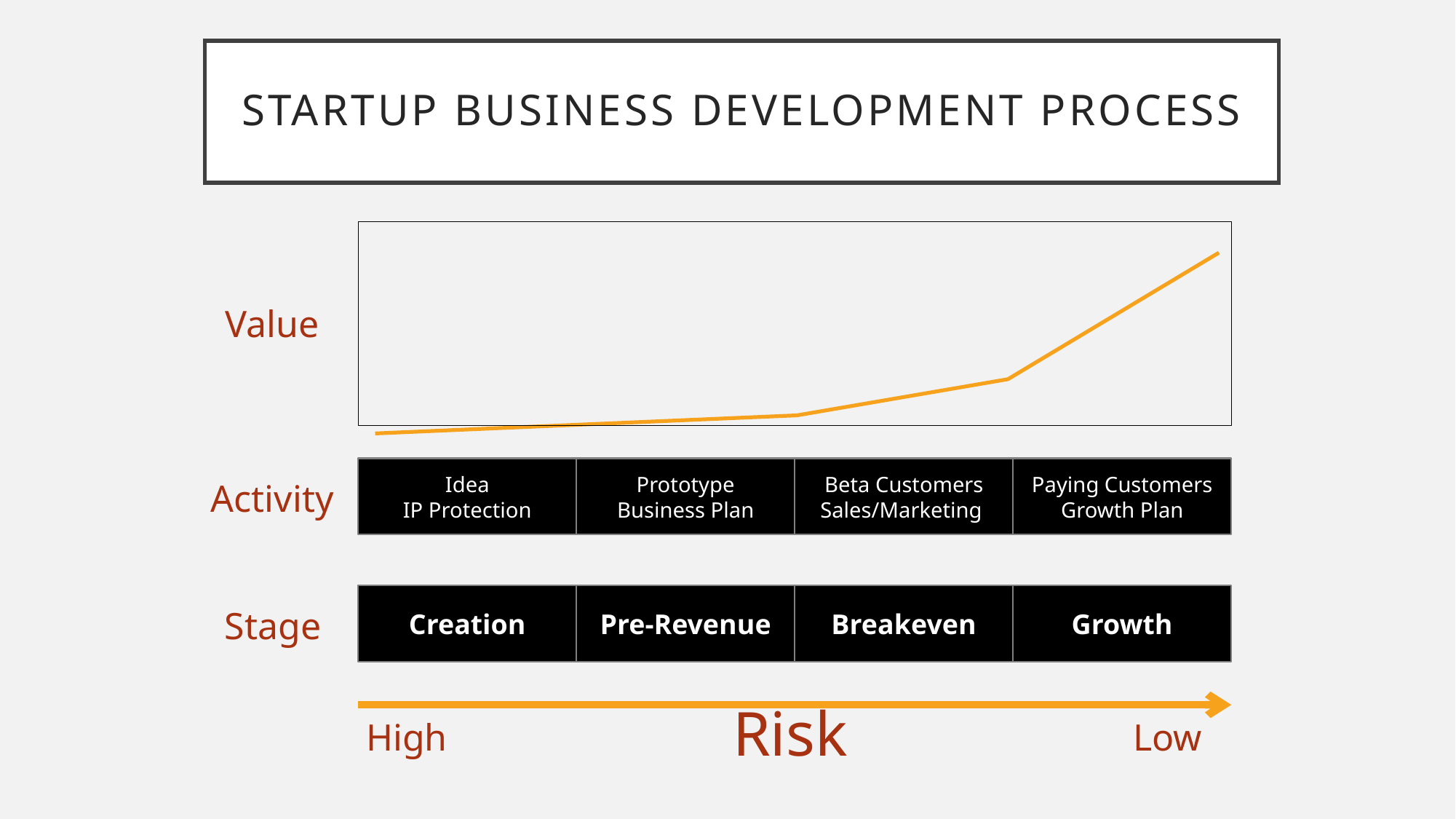
What label is given to the vertical axis of the chart? Value At which stage is the Value line highest? Growth Between which two stages does the Value line rise most steeply? Breakeven and Growth What kind of chart is shown on the slide? line chart What activities are listed for the Breakeven stage? Beta Customers, Sales/Marketing At which stage is the Value line lowest? Creation Which stage comes immediately after Pre-Revenue on the x axis? Breakeven How many stages are shown along the x axis of the chart? 4 Is the Value line higher at the Creation stage or at the Pre-Revenue stage? Pre-Revenue Does the Value line rise or fall as risk moves from High to Low along the x axis? rises Is the Value line higher at the Growth stage or at the Breakeven stage? Growth What is the title of the slide containing the chart? STARTUP BUSINESS DEVELOPMENT PROCESS